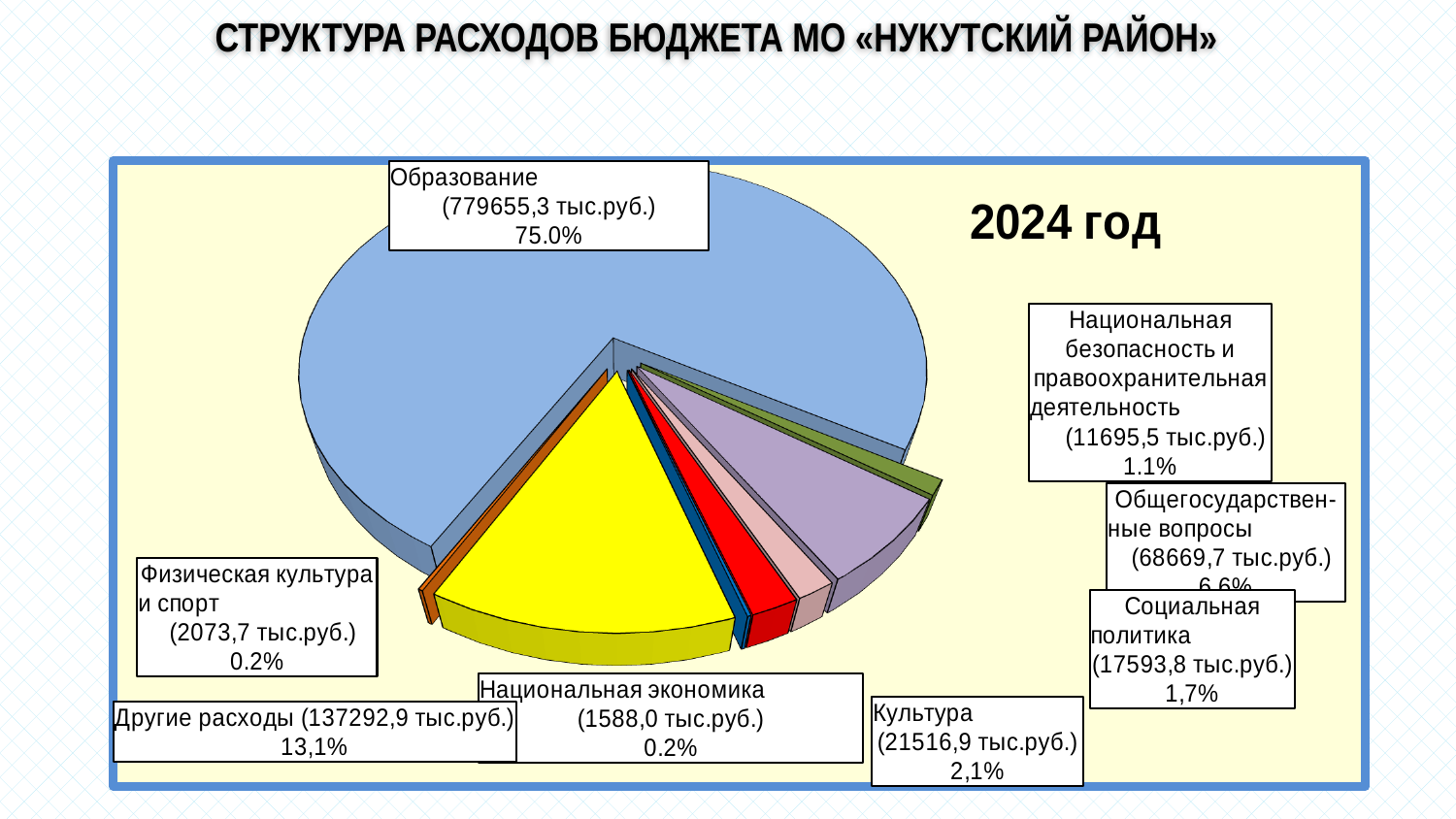
What is the amount shown for Социальная политика? 17593,8 тыс.руб. What is the difference in percentage points between Другие расходы and Культура? 11,0% What percentage is shown for Культура? 2,1% Which category has the largest share of the pie? Образование Which year does the chart refer to? 2024 год What is the amount shown for Другие расходы? 137292,9 тыс.руб. What is the title of the slide? СТРУКТУРА РАСХОДОВ БЮДЖЕТА МО «НУКУТСКИЙ РАЙОН» What share of budget expenditures does Образование account for? 75.0% How many categories are labelled on the pie chart? 8 Which is larger, the amount for Культура or the amount for Социальная политика? Культура What percentage is shown for Национальная безопасность и правоохранительная деятельность? 1.1% What kind of chart is shown on the slide? pie chart